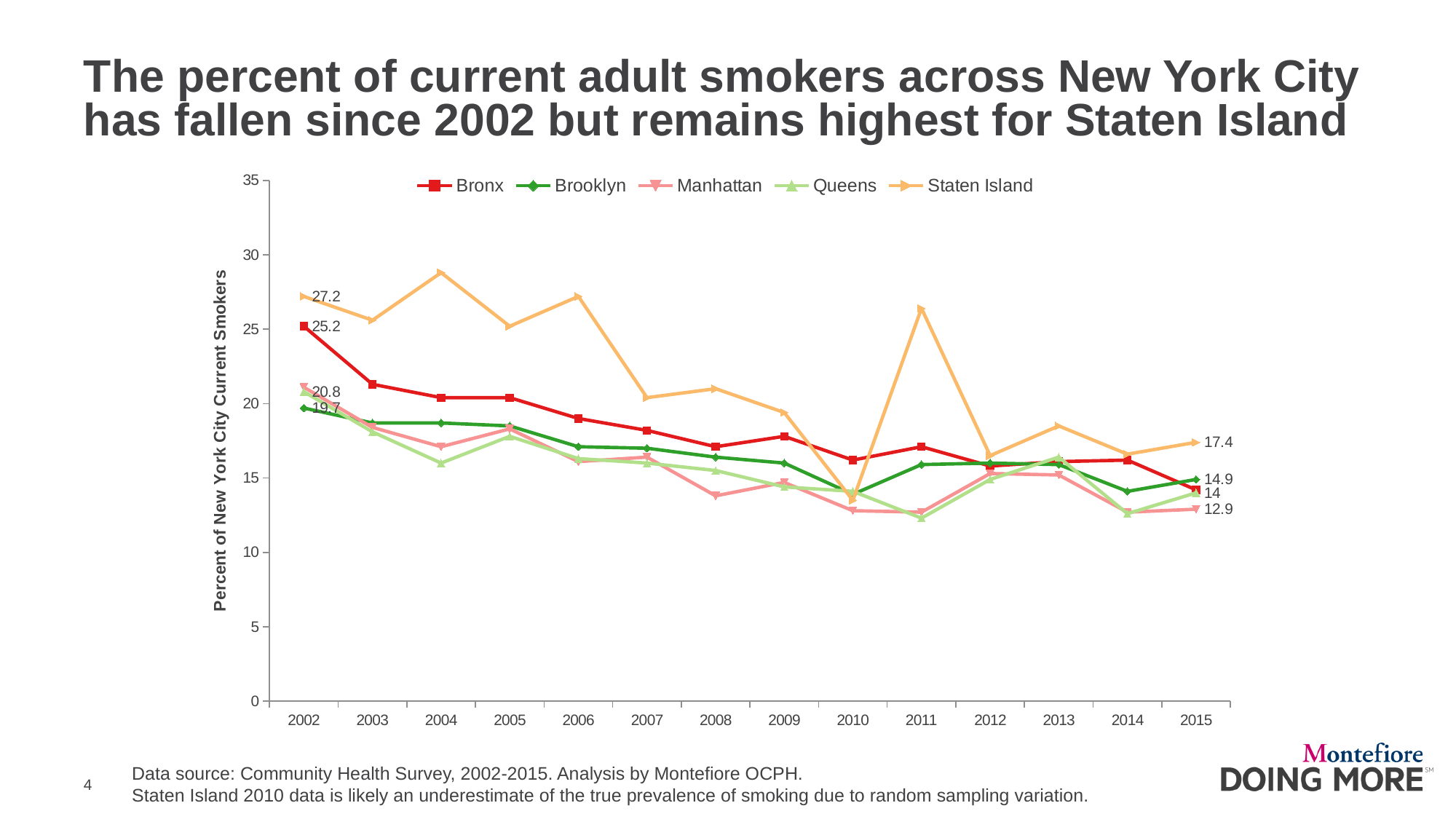
What was the percent of current smokers in the Bronx in 2002? 25.2 Which borough had the highest percent of current smokers in 2002? Staten Island How many series does the legend list? 5 What was the percent of current smokers in Brooklyn in 2015? 14.9 What type of chart is shown on the slide? Line chart How many years are plotted along the x axis? 14 Is the value for Staten Island in 2004 greater or less than 25? greater What was the percent of current smokers in Staten Island in 2002? 27.2 What was the percent of current smokers in Manhattan in 2015? 12.9 By how many percentage points did Staten Island's value fall from 2002 to 2015? 9.8 What was the percent of current smokers in Staten Island in 2015? 17.4 Does the Bronx line generally rise or fall from 2002 to 2015? Fall